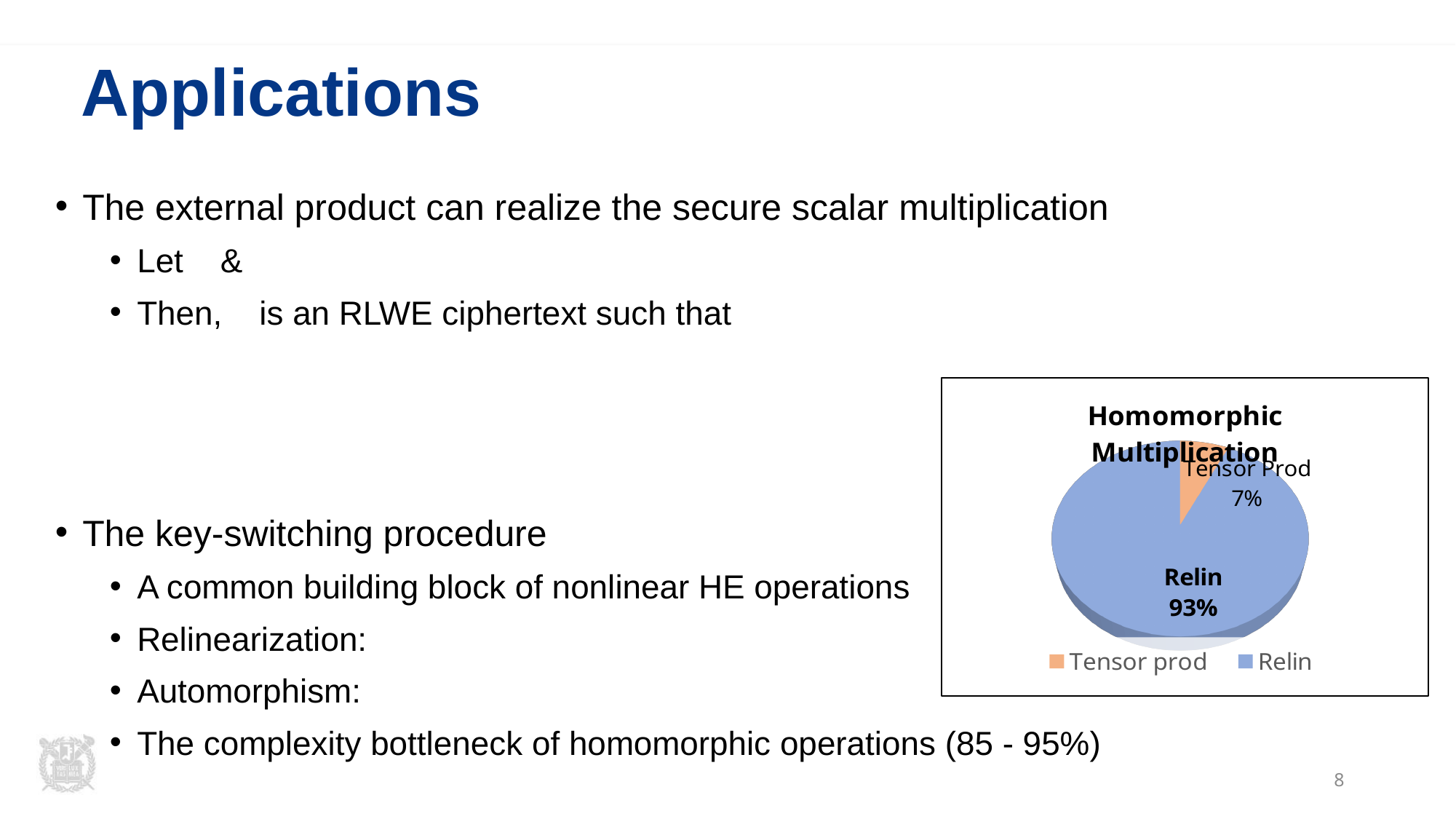
Which slice of the pie chart is the largest? Relin How many entries does the legend of the pie chart list? 2 How many slices does the pie chart have? 2 What share of the Homomorphic Multiplication pie chart does Tensor Prod take? 7% What kind of chart is shown on the slide? Pie chart Which is larger in the pie chart, Relin or Tensor Prod? Relin What colour is the Relin slice in the pie chart? Blue What is the difference in percentage points between the Relin and Tensor Prod slices? 86 Which slice of the pie chart is the smallest? Tensor Prod What share of the Homomorphic Multiplication pie chart does Relin take? 93% What is the title of the chart on the slide? Homomorphic Multiplication